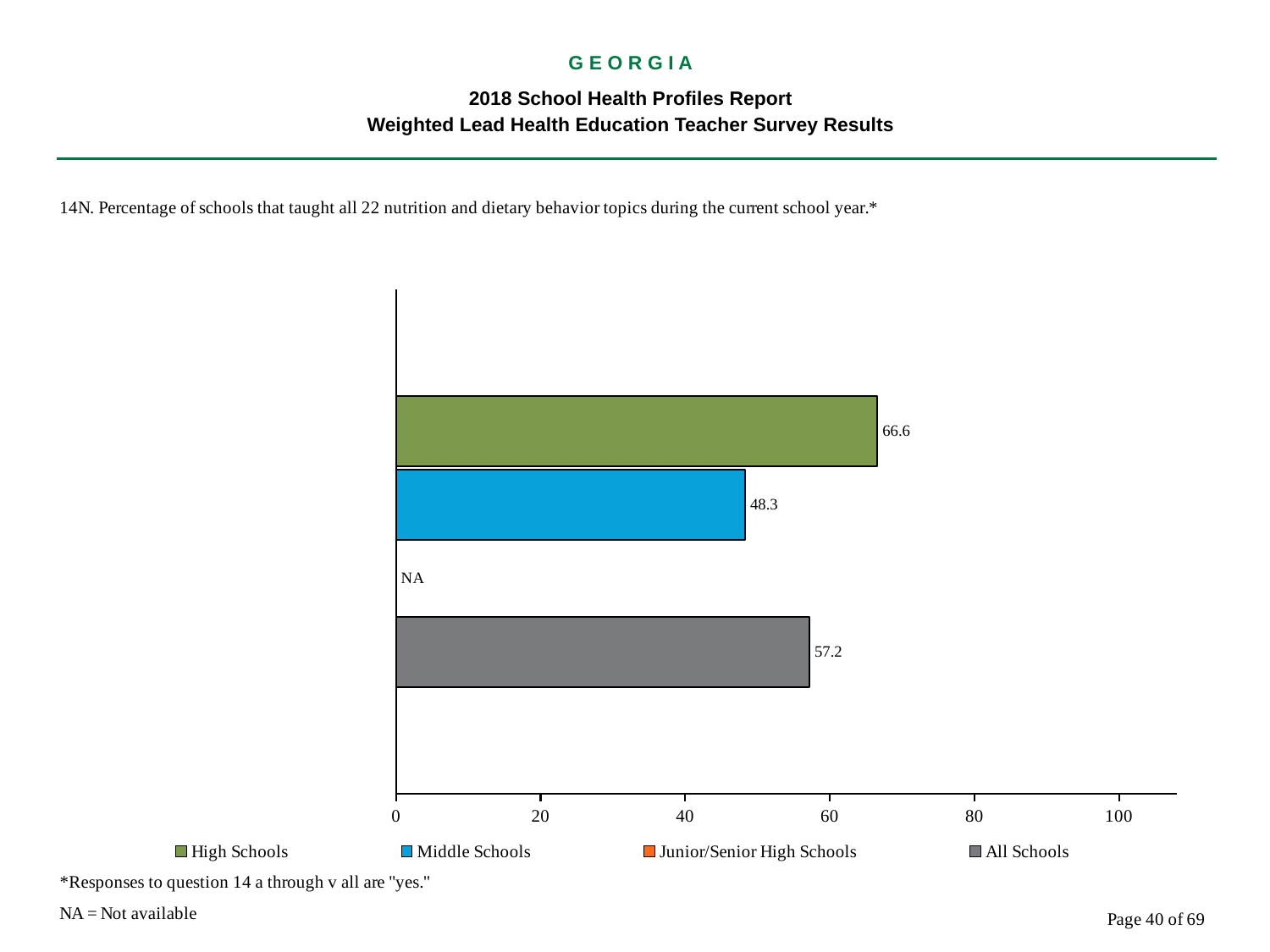
What is the value for Middle Schools? 48.3 Which school type with a plotted value has the lowest value? Middle Schools What is the difference between the High Schools and Middle Schools values? 18.3 Is the value for High Schools greater or less than 60? greater What is the value for High Schools? 66.6 How many entries does the legend list? 4 What kind of chart is shown on the slide? bar chart What is the value for All Schools? 57.2 Which is larger, the value for Middle Schools or the value for All Schools? All Schools What is the difference between the High Schools and All Schools values? 9.4 What is shown for Junior/Senior High Schools? NA Which school type has the highest value? High Schools